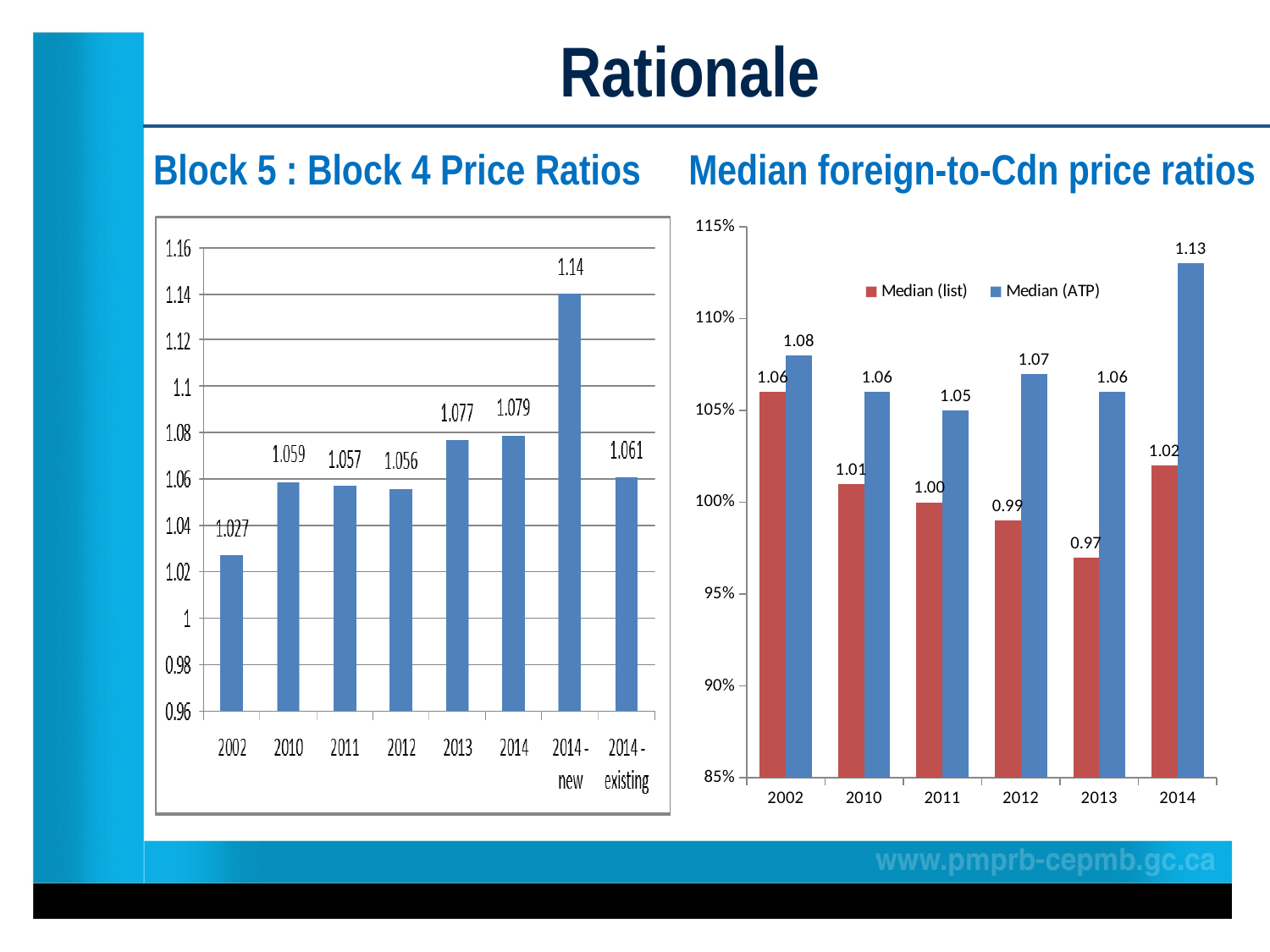
In the 'Median foreign-to-Cdn price ratios' chart, how many series does the legend list? 2 In the 'Block 5 : Block 4 Price Ratios' chart, what is the value for 2013? 1.077 In the 'Block 5 : Block 4 Price Ratios' chart, what is the value for 2002? 1.027 In the 'Block 5 : Block 4 Price Ratios' chart, which category has the highest value? 2014 - new In the 'Median foreign-to-Cdn price ratios' chart, what is the Median (list) value for 2013? 0.97 In the 'Median foreign-to-Cdn price ratios' chart, what is the Median (ATP) value for 2014? 1.13 In the 'Block 5 : Block 4 Price Ratios' chart, what is the difference between the values for 2014 - new and 2014 - existing? 0.079 In the 'Median foreign-to-Cdn price ratios' chart, which is larger for 2012: Median (list) or Median (ATP)? Median (ATP) In the 'Block 5 : Block 4 Price Ratios' chart, how many categories are shown on the x axis? 8 In the 'Block 5 : Block 4 Price Ratios' chart, which category has the lowest value? 2002 In the 'Median foreign-to-Cdn price ratios' chart, what is the difference between Median (ATP) and Median (list) for 2014? 0.11 What kind of chart is the 'Median foreign-to-Cdn price ratios' chart? Bar chart